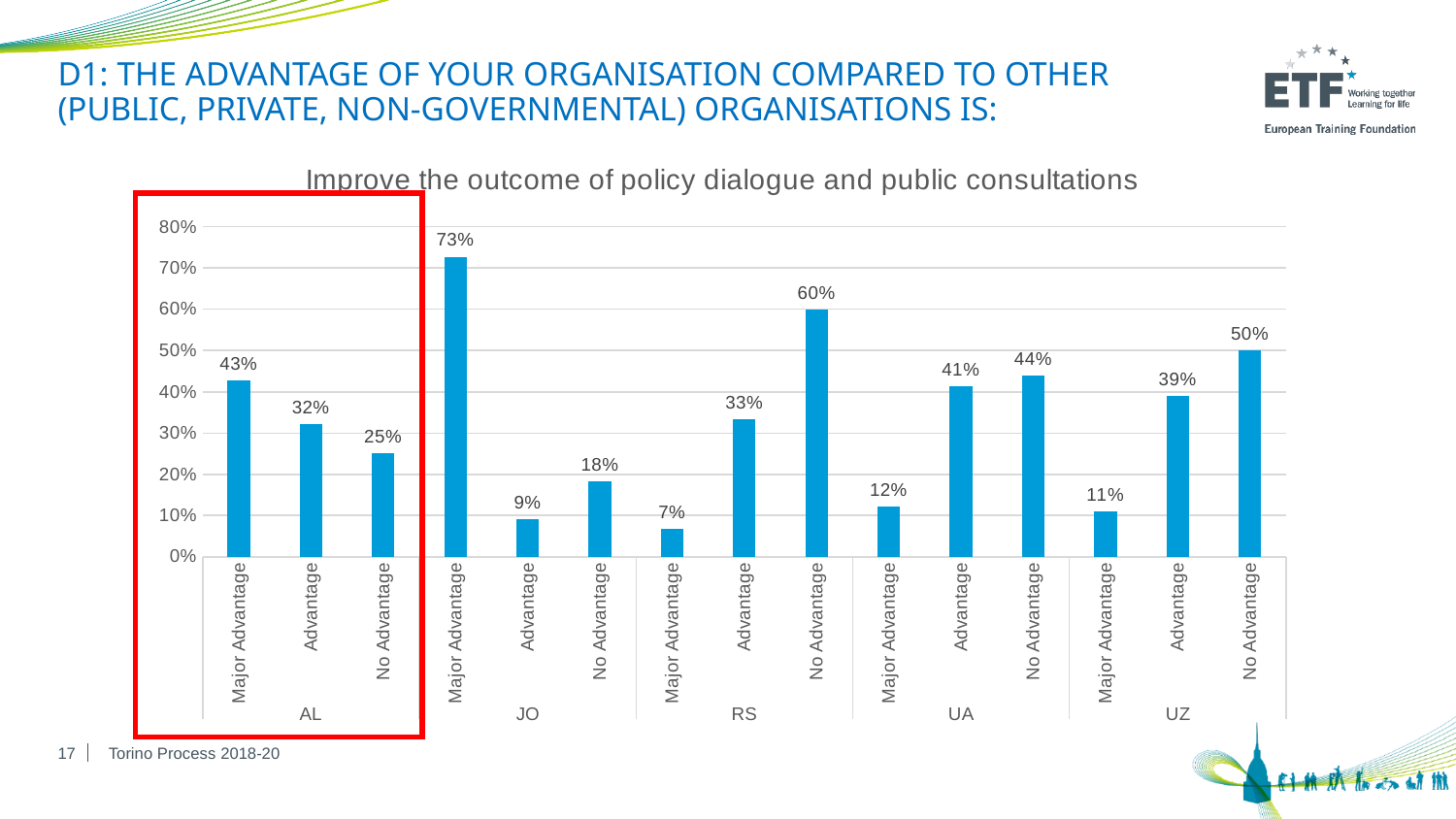
Is the value for Advantage in UA greater or less than 40%? greater What is the title of the chart? Improve the outcome of policy dialogue and public consultations What is the difference between Major Advantage and No Advantage in AL? 18% Which bar has the highest value on the chart? Major Advantage in JO What kind of chart is shown? Bar chart Which is larger: No Advantage in UA or No Advantage in UZ? No Advantage in UZ Which bar has the lowest value on the chart? Major Advantage in RS What is the value for Major Advantage in AL? 43% What is the value for Advantage in JO? 9% How many country groups are shown on the x axis? 5 What is the value for No Advantage in RS? 60% How many bars are plotted on the chart? 15